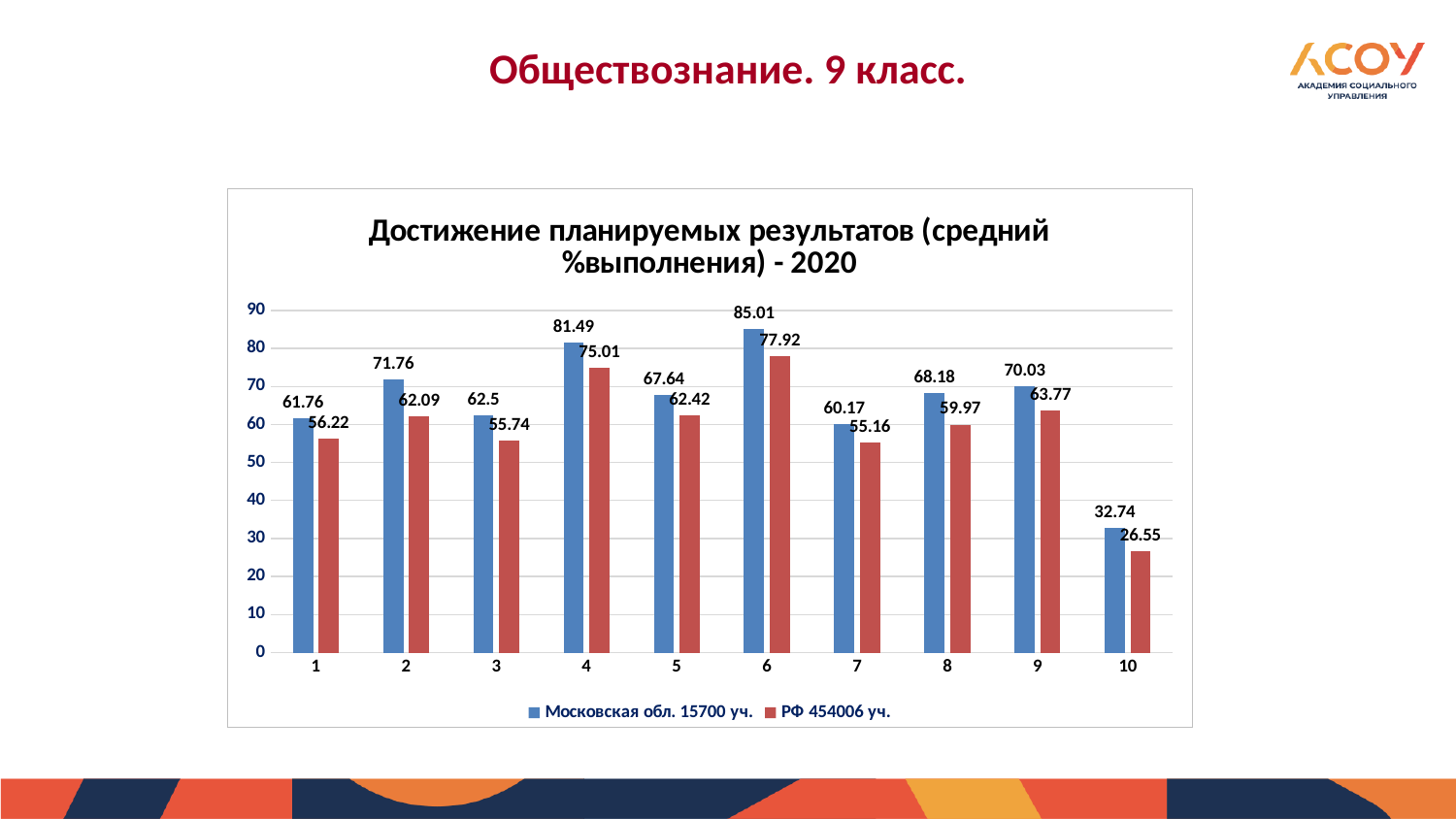
How many series does the legend list? 2 What type of chart is shown on the slide? bar chart What is the value for category 10 in the series "Московская обл. 15700 уч."? 32.74 What is the value for category 6 in the series "Московская обл. 15700 уч."? 85.01 What is the value for category 3 in the series "РФ 454006 уч."? 55.74 What is the difference between the "Московская обл. 15700 уч." and "РФ 454006 уч." values for category 4? 6.48 Which category has the highest value in the series "РФ 454006 уч."? 6 How many categories are shown on the x axis? 10 What is the title of the chart? Достижение планируемых результатов (средний %выполнения) - 2020 Which category has the lowest value in the series "Московская обл. 15700 уч."? 10 Is the value for category 2 in the series "РФ 454006 уч." greater or less than 70? less For category 9, which series has the larger value: "Московская обл. 15700 уч." or "РФ 454006 уч."? Московская обл. 15700 уч.